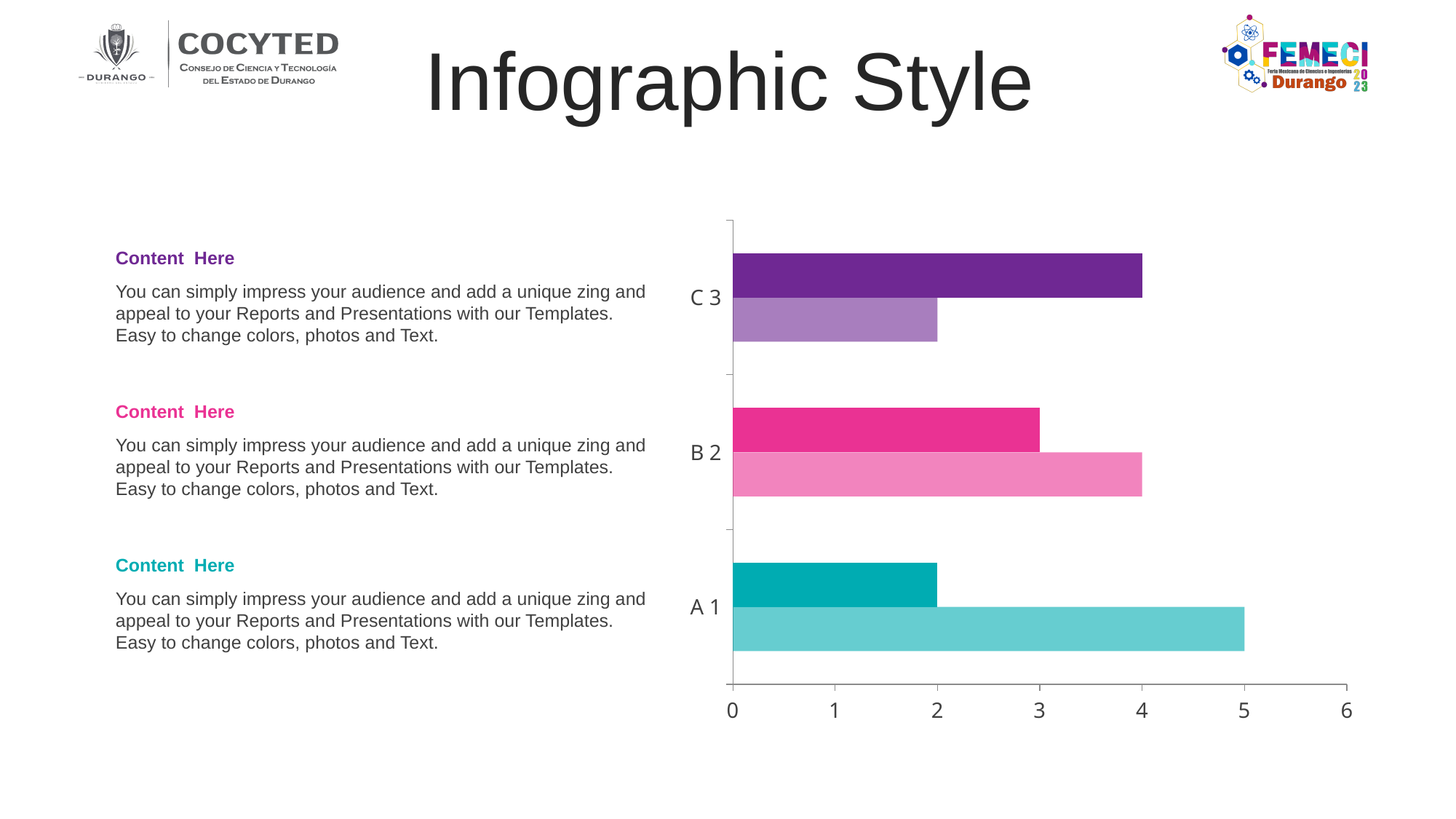
What kind of chart is shown on the slide? bar chart What is the value of the darker (upper) bar for category B 2? 3 What is the value of the lighter (lower) bar for category A 1? 5 What colour are the bars for category B 2? pink What is the highest value shown on the horizontal axis of the chart? 6 Is the value of the darker (upper) bar for category C 3 greater or less than 3? greater What is the difference between the two bars for category A 1? 3 What is the value of the lighter (lower) bar for category C 3? 2 For category B 2, which bar is longer, the darker (upper) bar or the lighter (lower) bar? the lighter (lower) bar Which category has the longest bar in the chart? A 1 How many categories are shown on the vertical axis of the chart? 3 What is the value of the darker (upper) bar for category A 1? 2